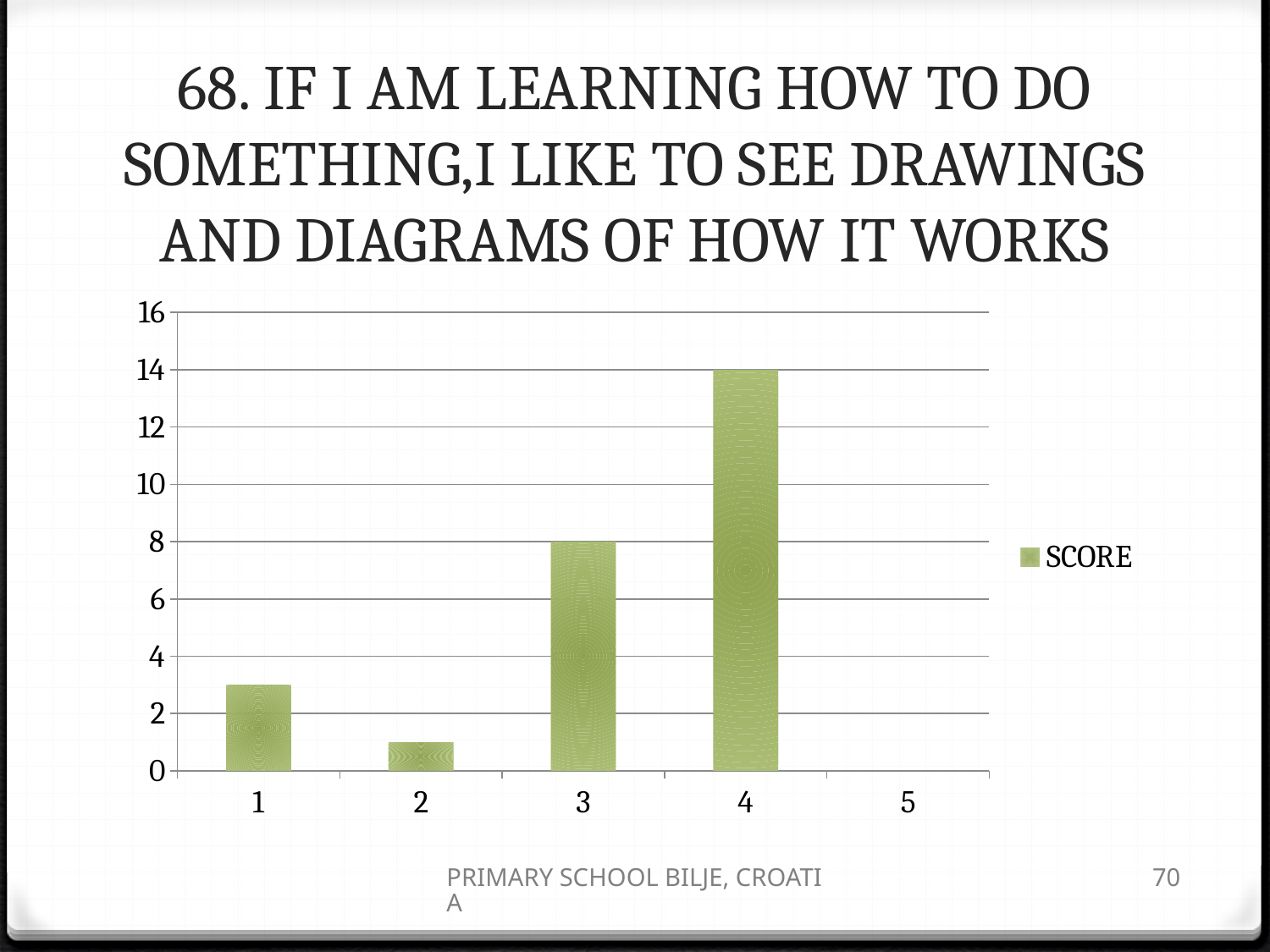
How many categories are shown on the x axis? 5 What is the SCORE value for category 3? 8 What kind of chart is shown on the slide? bar chart What is the difference between the SCORE for category 4 and category 3? 6 What is the name of the series shown in the legend? SCORE How many series does the legend list? 1 What is the SCORE value for category 4? 14 Is the value for category 1 greater or less than 2? greater Which has a larger SCORE, category 2 or category 1? 1 Is the value for category 2 greater or less than 2? less Which category has the highest SCORE? 4 Which has a larger SCORE, category 1 or category 3? 3